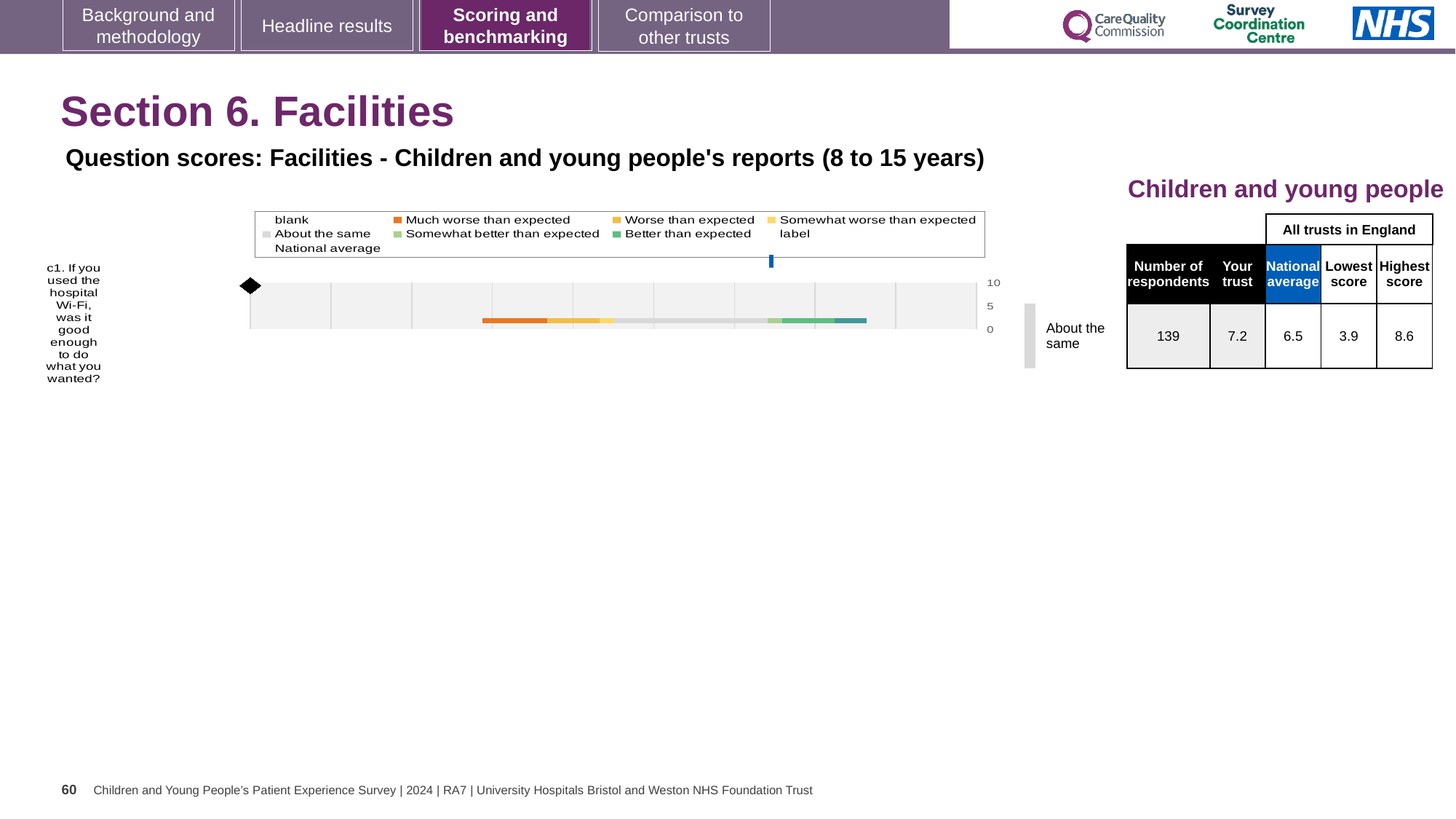
What is the highest score among all trusts in England for question c1? 8.6 What is the national average score for question c1 (hospital Wi-Fi)? 6.5 How many survey questions are plotted in the chart? 1 Which legend entry is shown in orange? Much worse than expected What is the lowest score among all trusts in England for question c1? 3.9 What kind of chart is shown for question c1 about the hospital Wi-Fi? bar chart How many respondents answered question c1 (hospital Wi-Fi)? 139 Is the 'Your trust' score for question c1 higher or lower than the national average? higher What is the difference between the highest score and the lowest score for question c1? 4.7 What is the 'Your trust' score for question c1 (hospital Wi-Fi)? 7.2 What benchmark category is question c1 (hospital Wi-Fi) assigned to? About the same What is the highest value shown on the chart's axis? 10